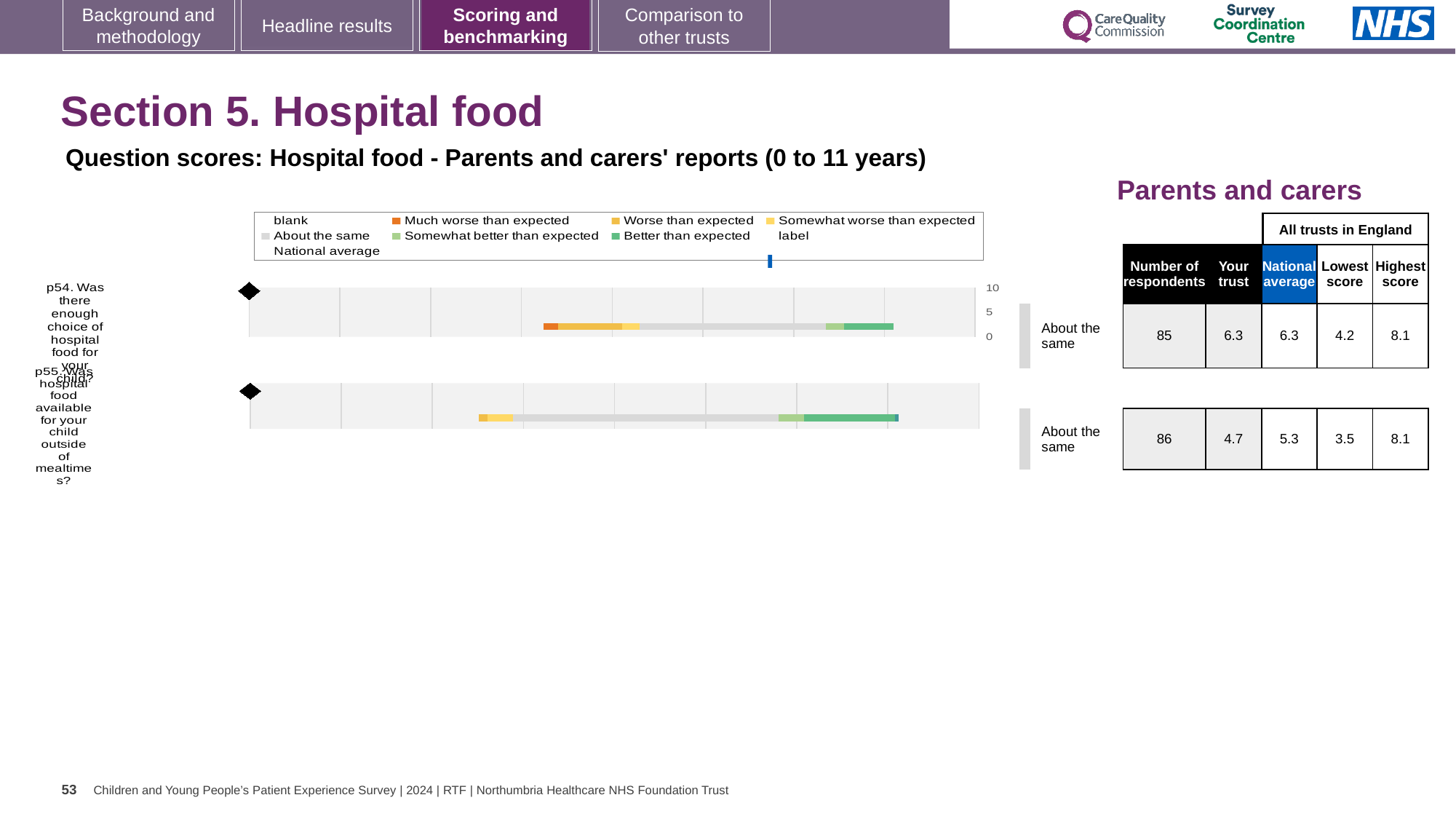
What is the highest score among all trusts in England for p55? 8.1 What is the 'Your trust' score for p54 (enough choice of hospital food for your child)? 6.3 What is the difference between the national average and the 'Your trust' score for p55? 0.6 What is the 'Your trust' score for p55 (hospital food available outside of mealtimes)? 4.7 How many respondents answered p55? 86 What is the lowest score among all trusts in England for p54? 4.2 What is the national average score for p55? 5.3 What benchmark category is shown for p54? About the same Which question has the higher 'Your trust' score, p54 or p55? p54 What kind of chart is used to show the question scores on this slide? bar chart How many questions (categories) are plotted in the chart? 2 What is the maximum value shown on the chart's score axis? 10